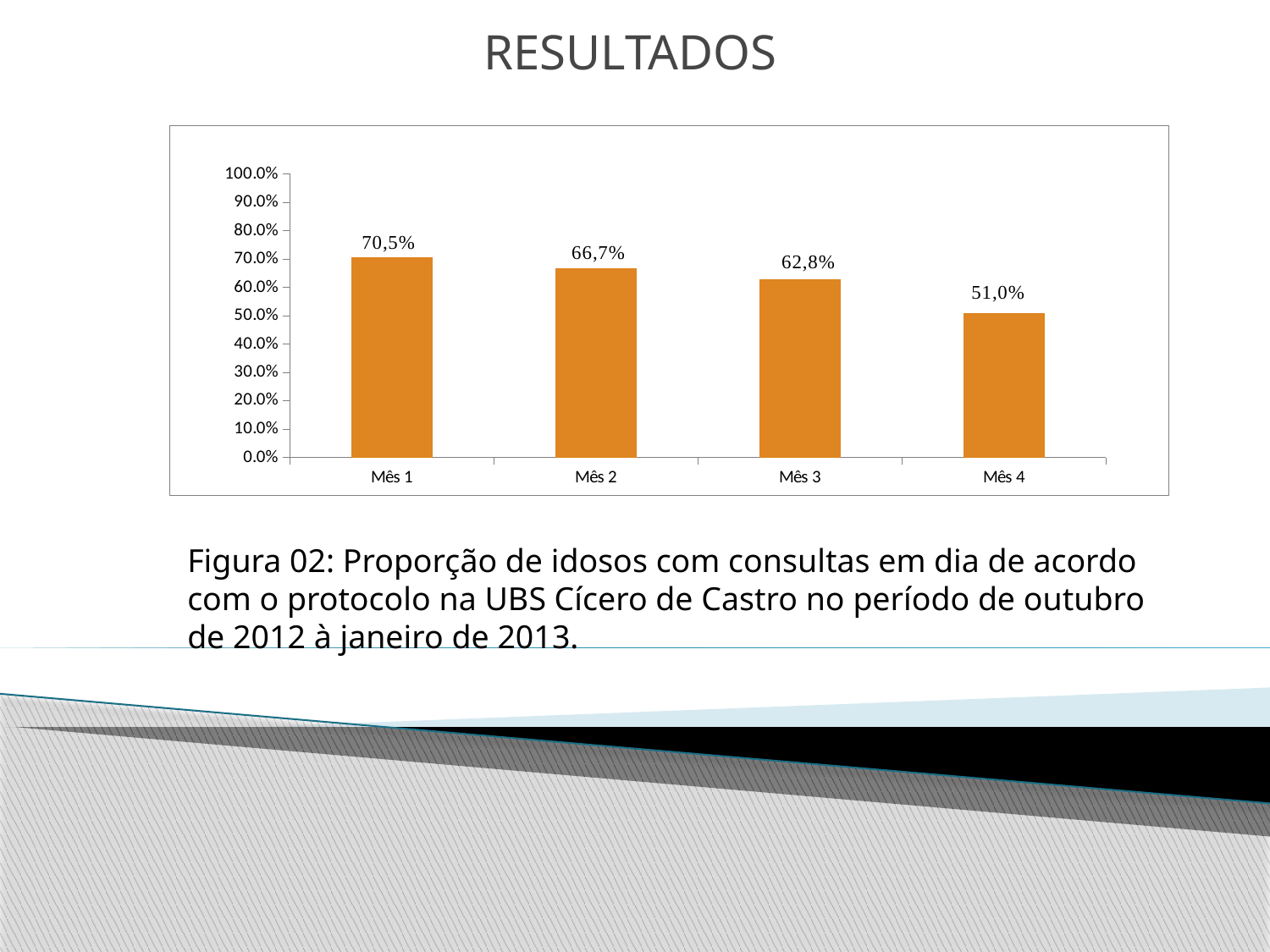
Is the value for Mês 4 greater or less than 60.0%? less What is the difference between the values for Mês 2 and Mês 3? 3,9 percentage points Which is larger, the value for Mês 2 or the value for Mês 3? Mês 2 Which month has the highest value? Mês 1 What is the value for Mês 3? 62,8% Do the values rise or fall from Mês 1 to Mês 4? Fall Which month has the lowest value? Mês 4 What is the difference between the values for Mês 1 and Mês 4? 19,5 percentage points What is the value for Mês 1? 70,5% What kind of chart is shown on the slide? Bar chart How many months are shown on the x axis? 4 What is the value for Mês 4? 51,0%